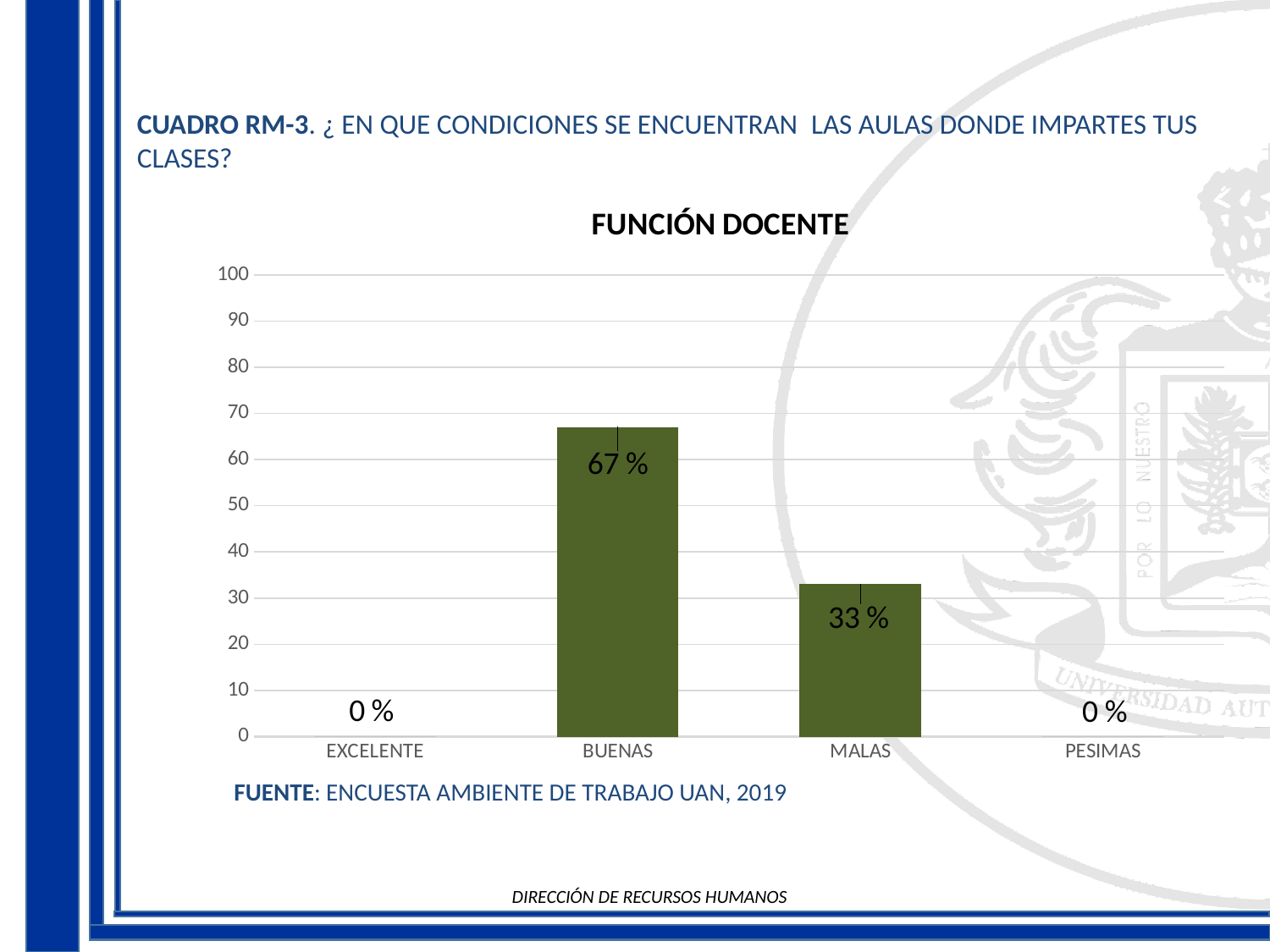
How many categories are shown on the x axis? 4 What is the difference between the values for BUENAS and MALAS? 34 % Which category has the highest value? BUENAS What is the value for MALAS? 33 % What kind of chart is shown on the slide? bar chart What is the title of the chart? FUNCIÓN DOCENTE What is the value for PESIMAS? 0 % What is the value for BUENAS? 67 % Is the value for BUENAS greater or less than 60? greater Is the value for MALAS greater or less than 40? less Which is larger, the value for BUENAS or the value for MALAS? BUENAS What is the value for EXCELENTE? 0 %